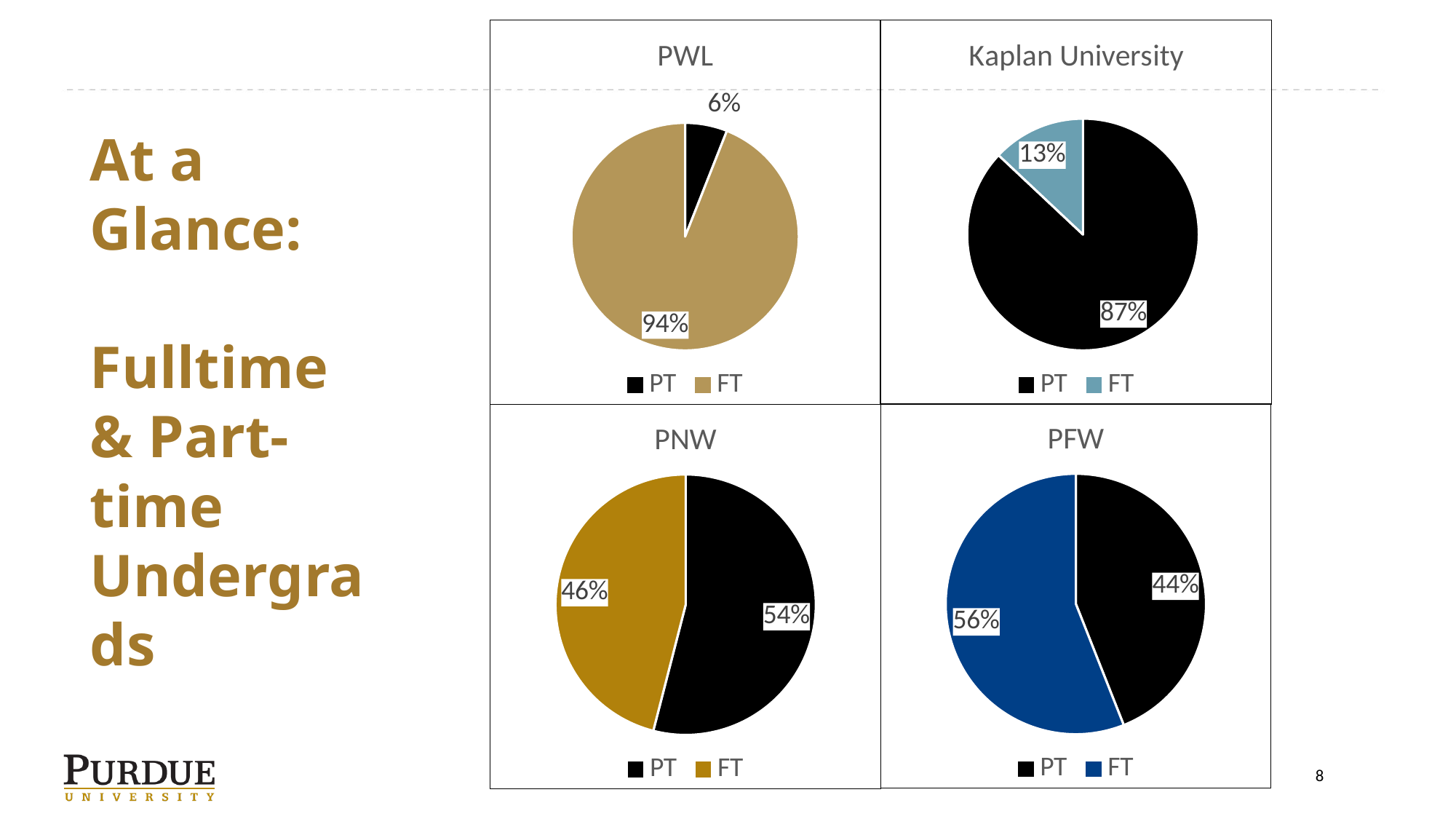
How many charts are shown on the slide? 4 In the PNW chart, what share of undergraduates are part-time (PT)? 54% In the PWL chart, what is the difference in percentage points between the FT and PT shares? 88 In the PWL chart, what share of undergraduates are part-time (PT)? 6% In the PNW chart, which slice is larger, PT or FT? PT In the Kaplan University chart, what share of undergraduates are part-time (PT)? 87% In the PFW chart, which slice is larger, PT or FT? FT In the PFW chart, what share of undergraduates are full-time (FT)? 56% In the PWL chart, what share of undergraduates are full-time (FT)? 94% In the Kaplan University chart, what is the difference in percentage points between the PT and FT shares? 74 In the Kaplan University chart, what share of undergraduates are full-time (FT)? 13% What kind of chart is used for PFW? Pie chart